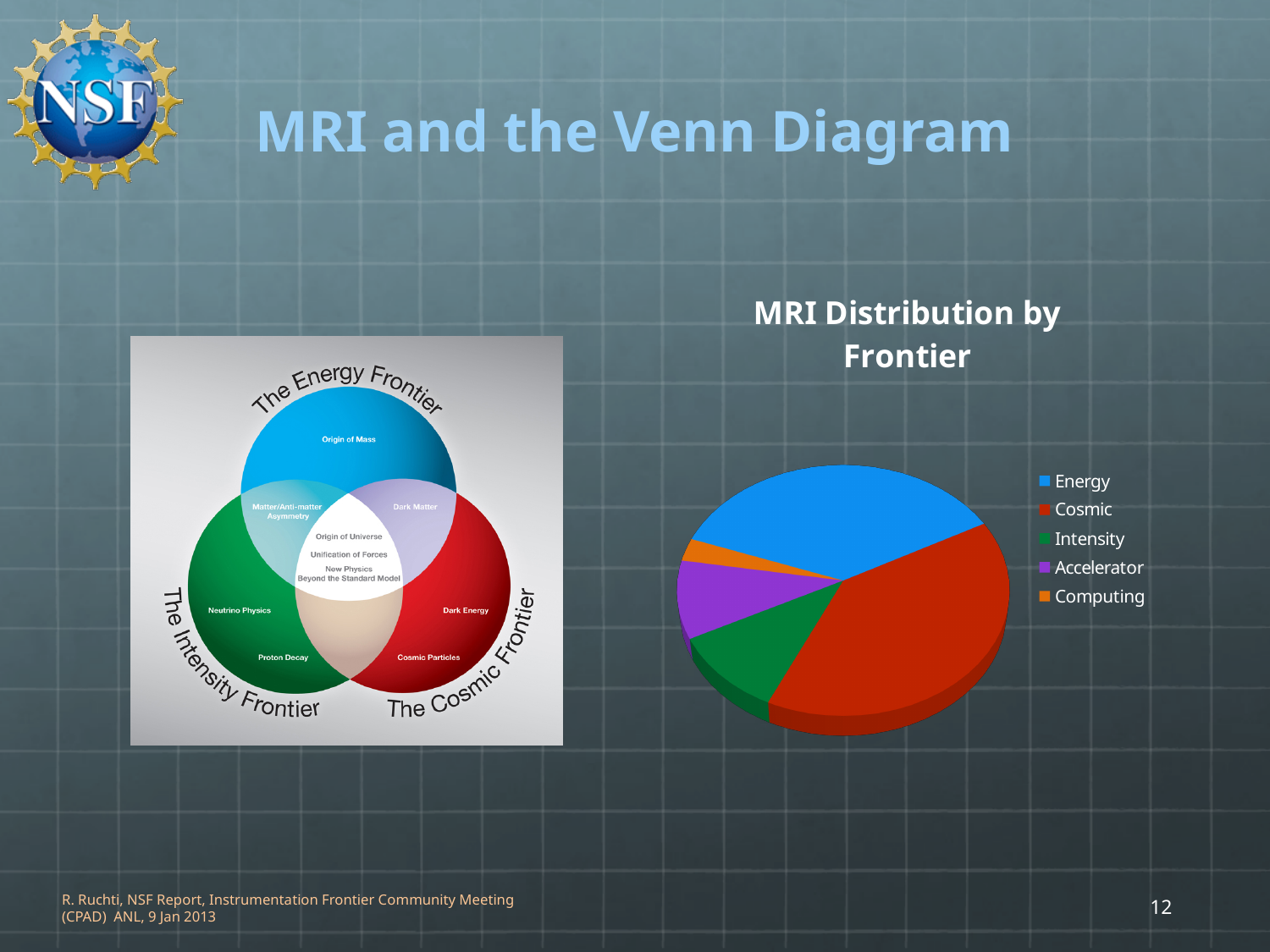
In the pie chart "MRI Distribution by Frontier", which frontier has the largest slice? Cosmic In the pie chart "MRI Distribution by Frontier", which slice is larger, Cosmic or Accelerator? Cosmic In the pie chart "MRI Distribution by Frontier", which frontier has the smallest slice? Computing In the pie chart "MRI Distribution by Frontier", which slice is larger, Energy or Intensity? Energy What kind of chart is shown under the title "MRI Distribution by Frontier"? pie chart How many entries does the legend of the pie chart "MRI Distribution by Frontier" list? 5 In the pie chart "MRI Distribution by Frontier", which slice is larger, Cosmic or Energy? Cosmic How many slices does the pie chart "MRI Distribution by Frontier" have? 5 What is the title of the pie chart on the slide? MRI Distribution by Frontier In the pie chart "MRI Distribution by Frontier", what colour represents the Cosmic frontier? red